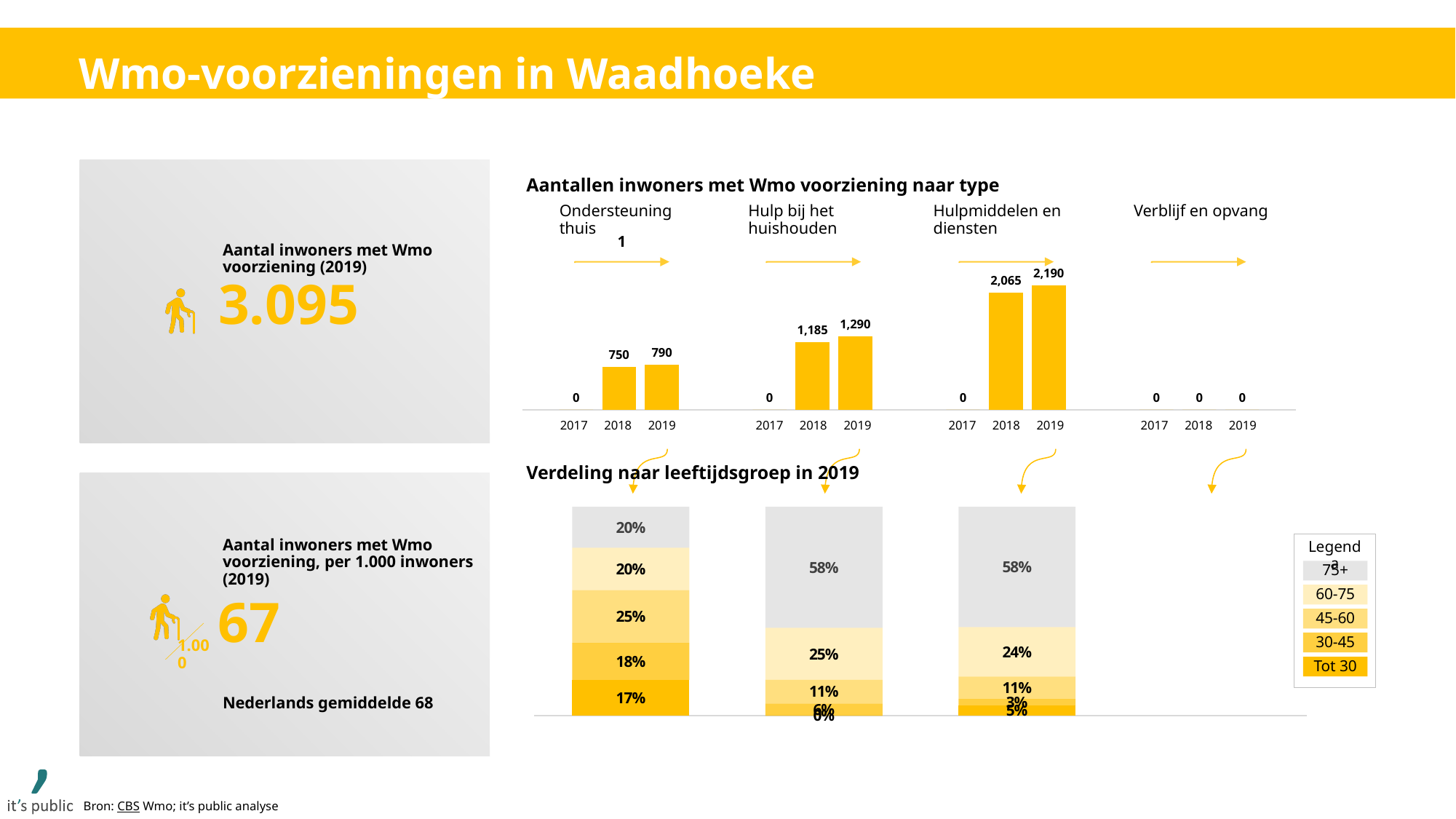
In the chart 'Aantallen inwoners met Wmo voorziening naar type', do the values for Hulpmiddelen en diensten rise or fall from 2017 to 2019? rise In the chart 'Verdeling naar leeftijdsgroep in 2019', what is the share of the 75+ age group for Hulp bij het huishouden? 58% In the chart 'Aantallen inwoners met Wmo voorziening naar type', what is the value for Ondersteuning thuis in 2019? 790 In the chart 'Aantallen inwoners met Wmo voorziening naar type', which type has the highest value in 2019? Hulpmiddelen en diensten In the chart 'Verdeling naar leeftijdsgroep in 2019', what is the share of the 45-60 age group for Ondersteuning thuis? 25% In the chart 'Aantallen inwoners met Wmo voorziening naar type', what is the value for Verblijf en opvang in 2019? 0 In the chart 'Aantallen inwoners met Wmo voorziening naar type', what is the value for Hulpmiddelen en diensten in 2019? 2,190 How many age groups does the legend of the chart 'Verdeling naar leeftijdsgroep in 2019' list? 5 In the chart 'Aantallen inwoners met Wmo voorziening naar type', which is larger: Ondersteuning thuis in 2019 or Hulp bij het huishouden in 2019? Hulp bij het huishouden in 2019 In the chart 'Aantallen inwoners met Wmo voorziening naar type', what is the value for Hulp bij het huishouden in 2018? 1,185 In the chart 'Aantallen inwoners met Wmo voorziening naar type', what is the difference between the 2019 and 2018 values for Hulp bij het huishouden? 105 In the chart 'Aantallen inwoners met Wmo voorziening naar type', what is the difference between the 2019 and 2018 values for Hulpmiddelen en diensten? 125